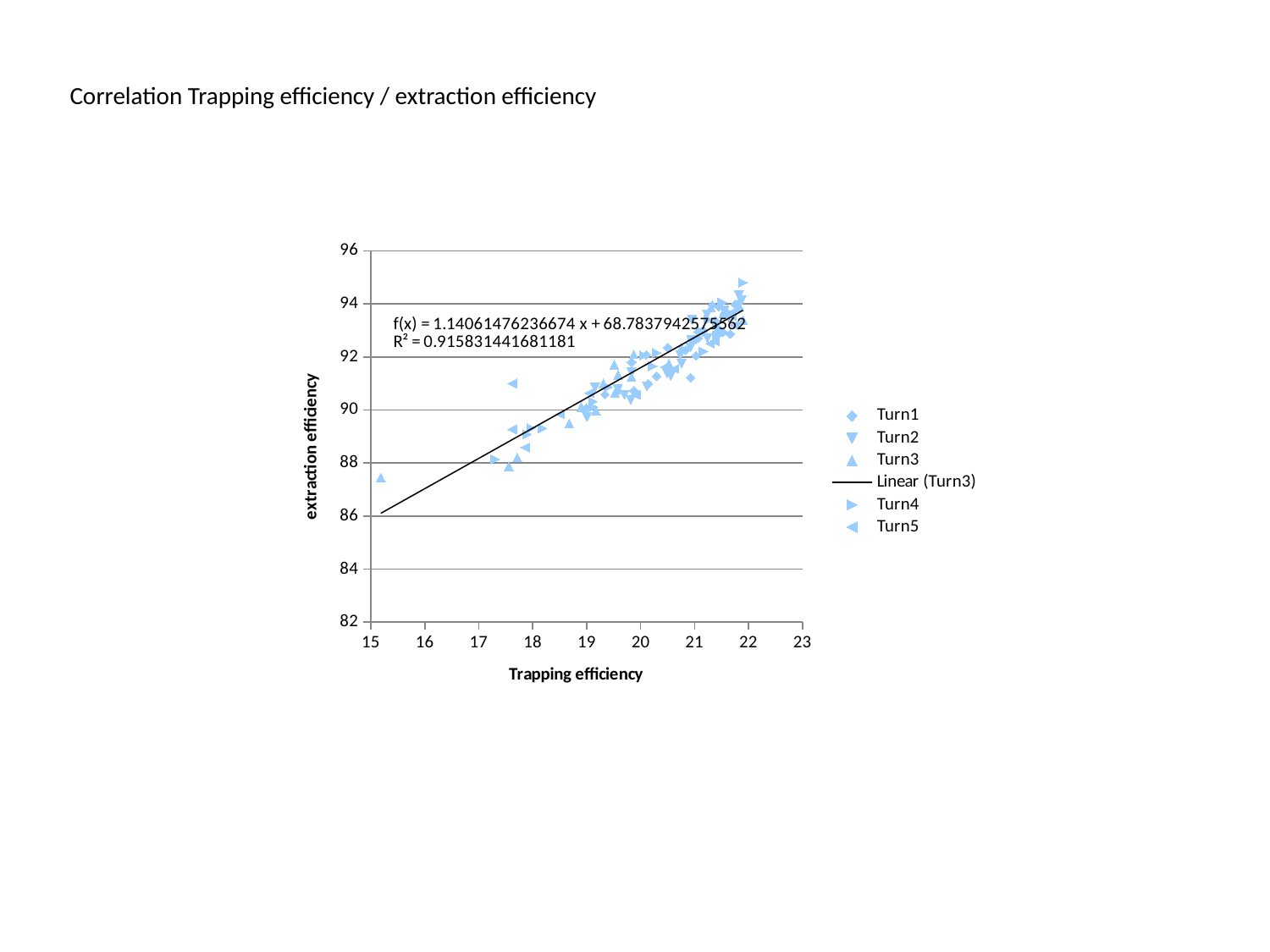
Is the extraction efficiency of the highest point (near trapping efficiency 22) greater or less than 94? greater Is the extraction efficiency of the isolated point near trapping efficiency 15.2 greater or less than 90? less What kind of chart is shown on the slide? scatter chart What is the intercept of the fitted line shown in the equation on the chart? 68.7837942575562 What is the maximum value shown on the y axis? 96 What is the label of the x axis? Trapping efficiency Which series is the linear trendline fitted to, according to the legend? Turn3 Do the extraction efficiency values generally rise or fall as trapping efficiency increases? rise Is the extraction efficiency of the isolated point near trapping efficiency 15.2 greater or less than 86? greater What is the slope of the fitted line shown in the equation on the chart? 1.14061476236674 What R² value is printed on the chart? 0.915831441681181 How many entries does the chart legend list? 6